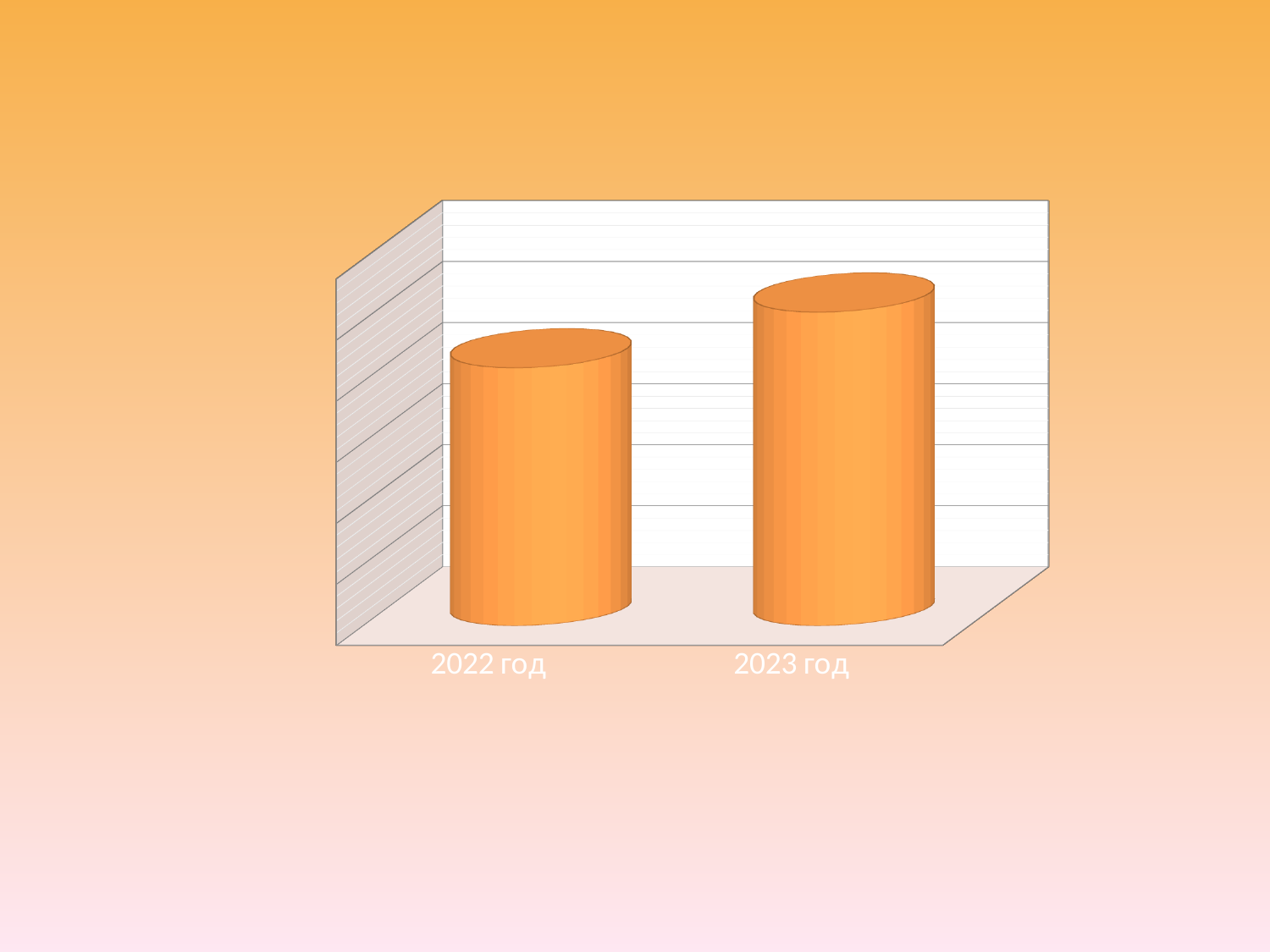
Which category has the lowest value on the chart? 2022 год Which category has the highest value on the chart? 2023 год How many categories are plotted on the chart? 2 What kind of chart is shown on the slide? bar chart What colour are the bars on the chart? orange What is the label of the first category on the x axis? 2022 год Do the values rise or fall from 2022 год to 2023 год? rise Which is larger, the value for 2022 год or the value for 2023 год? 2023 год